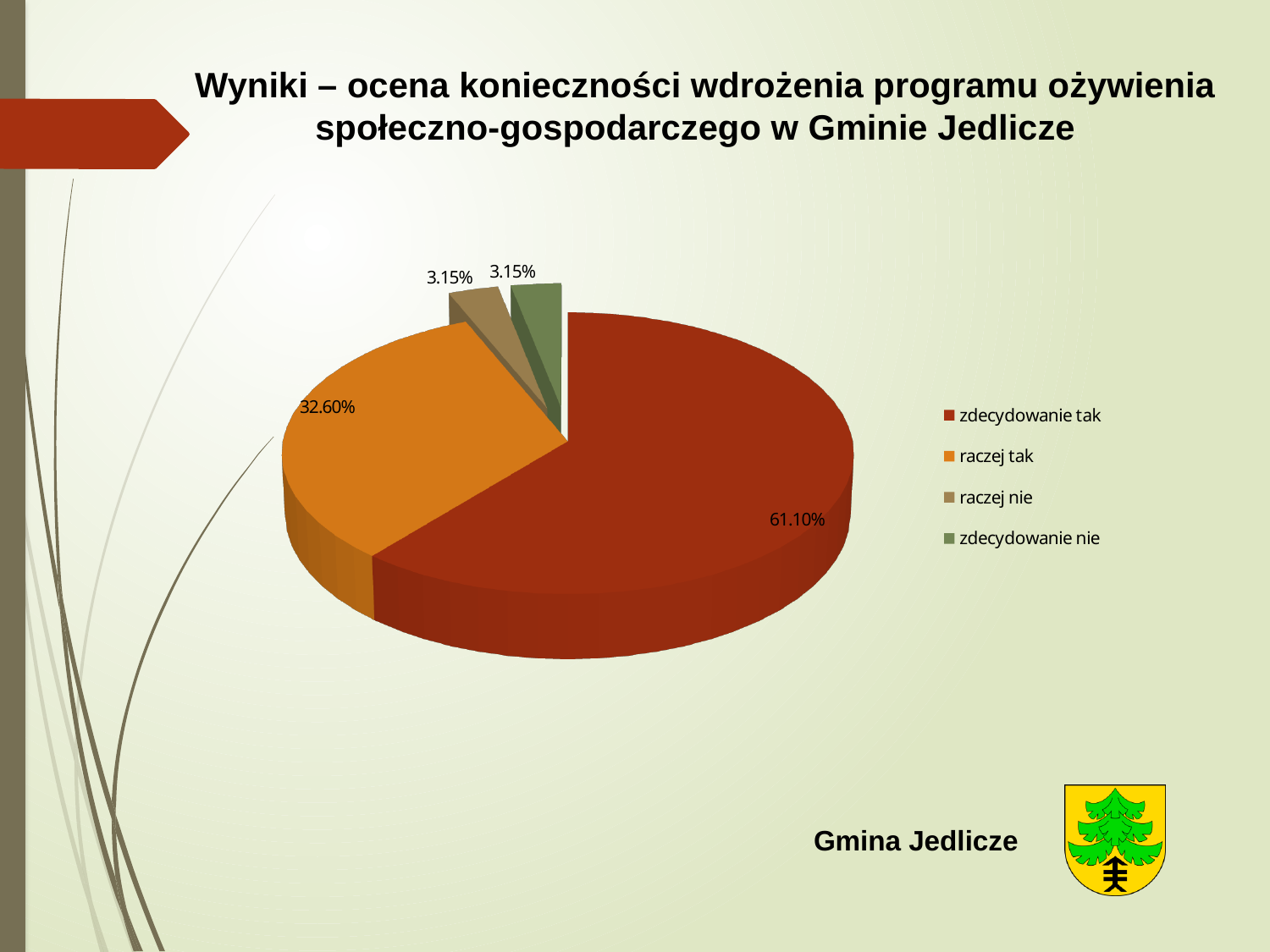
Which is larger, the share of "raczej tak" or the share of "raczej nie"? raczej tak What colour is the slice for "raczej tak"? orange Is the share of "zdecydowanie tak" greater or less than 50%? greater What kind of chart is shown on the slide? pie chart How many categories does the legend list? 4 What share of the pie does "zdecydowanie tak" have? 61.10% Which category has the largest slice of the pie? zdecydowanie tak What share of the pie does "raczej nie" have? 3.15% What is the difference between the shares of "zdecydowanie tak" and "raczej tak"? 28.50% What is the combined share of "raczej nie" and "zdecydowanie nie"? 6.30% What share of the pie does "zdecydowanie nie" have? 3.15% What share of the pie does "raczej tak" have? 32.60%